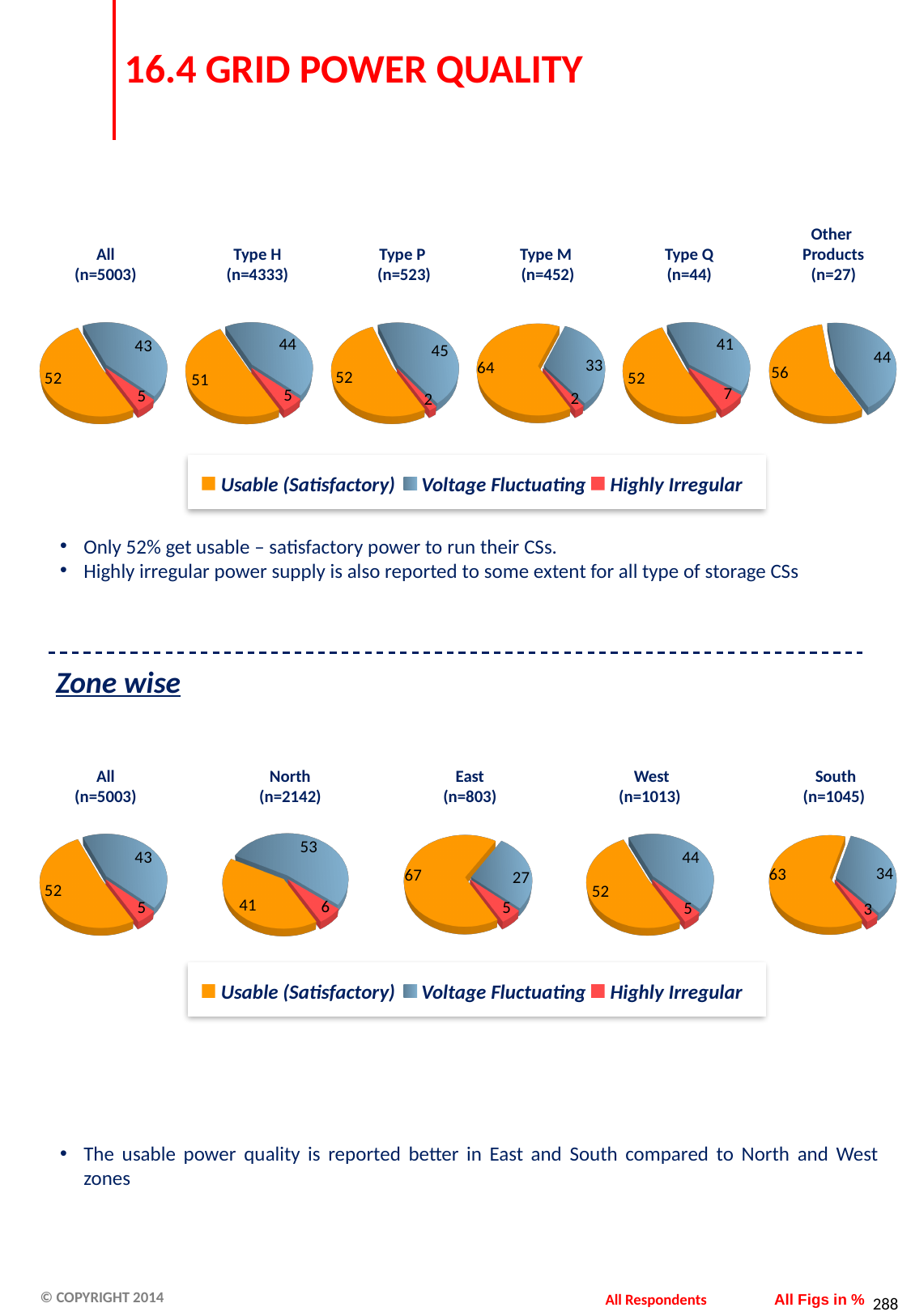
In the Zone wise row, what is the difference between the Usable (Satisfactory) values for East (n=803) and North (n=2142)? 26 In the top row of pie charts, what is the Highly Irregular value for Type Q (n=44)? 7 In the top row of pie charts, what is the Usable (Satisfactory) value for Type M (n=452)? 64 Among the top row pie charts, which category has the lowest Voltage Fluctuating value? Type M In the Zone wise row of pie charts, what is the Voltage Fluctuating value for North (n=2142)? 53 In the Zone wise row of pie charts, what is the Usable (Satisfactory) value for East (n=803)? 67 In the Zone wise row, which is larger: the Usable (Satisfactory) value for North or the Voltage Fluctuating value for North? Voltage Fluctuating How many series does the legend list for the pie charts? 3 In the top row of pie charts, what is the Voltage Fluctuating value for Type P (n=523)? 45 What type of chart is used on this slide? Pie chart In the Zone wise row of pie charts, what is the Highly Irregular value for South (n=1045)? 3 Among the Zone wise pie charts, which zone (excluding All) has the highest Usable (Satisfactory) value? East